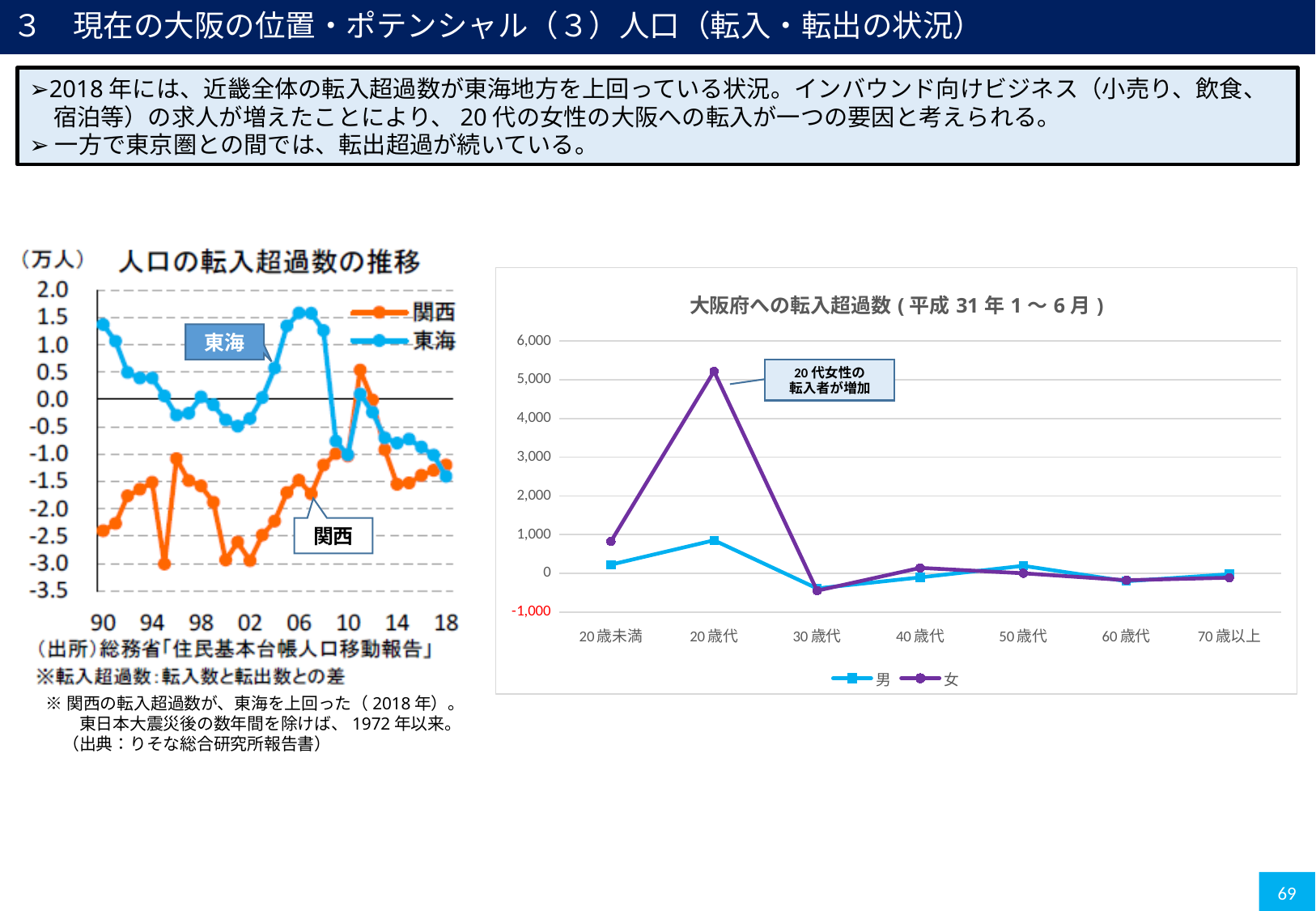
In the chart titled 大阪府への転入超過数(平成31年1～6月), which age category has the lowest value for 女? 30歳代 What type of chart is the chart titled 大阪府への転入超過数(平成31年1～6月)? line chart What does the annotation box in the chart titled 大阪府への転入超過数(平成31年1～6月) say? 20代女性の転入者が増加 In the chart titled 大阪府への転入超過数(平成31年1～6月), is the value for 男 at 20歳代 greater or less than 1,000? less How many age categories are shown on the x axis of the chart titled 大阪府への転入超過数(平成31年1～6月)? 7 In the chart titled 大阪府への転入超過数(平成31年1～6月), which age category has the highest value for 女? 20歳代 How many series does the legend of the chart titled 大阪府への転入超過数(平成31年1～6月) list? 2 How many series does the legend of the chart titled 人口の転入超過数の推移 list? 2 In the chart titled 人口の転入超過数の推移, is the value for 東海 in 06 greater or less than 1.0? greater In the chart titled 大阪府への転入超過数(平成31年1～6月), which age category has the highest value for 男? 20歳代 In the chart titled 大阪府への転入超過数(平成31年1～6月), is the value for 女 at 20歳代 greater or less than 4,000? greater In the chart titled 大阪府への転入超過数(平成31年1～6月), which series has the larger value at 20歳代, 男 or 女? 女